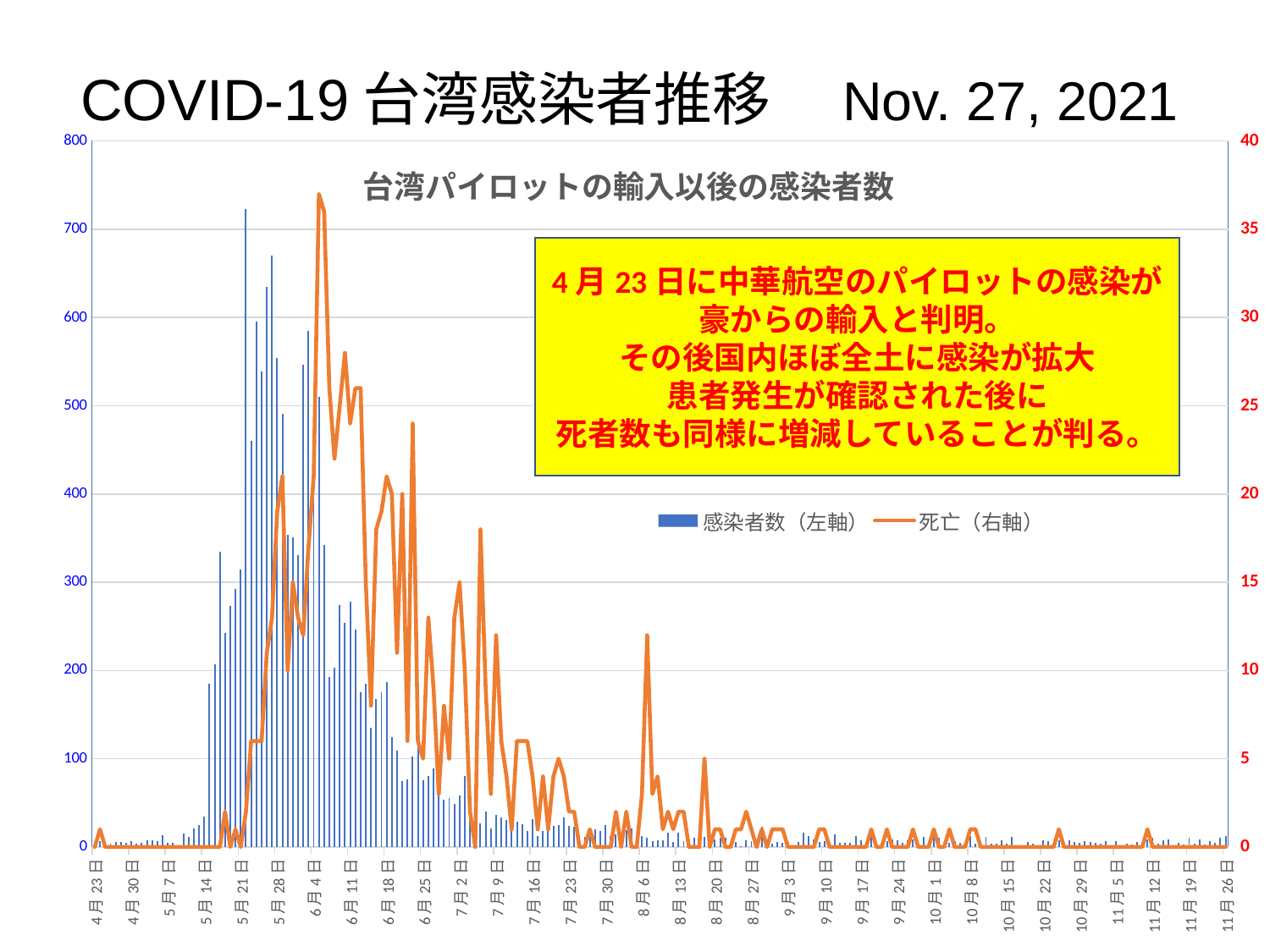
How many series does the chart legend list? 2 Is the highest value of 感染者数 greater or less than 600? greater Is the value of 死亡 at the spike around 8月6日 greater or less than 5? greater Which is larger: the 感染者数 value in late May or the 感染者数 value in mid October? late May Do the 感染者数 values rise or fall from early June to late November? fall What is the maximum value shown on the left vertical axis? 800 Which series is plotted as the orange line? 死亡（右軸） Is the highest value of 死亡 greater or less than 30? greater Which series is plotted as blue bars? 感染者数（左軸） What is the maximum value shown on the right vertical axis? 40 What is the first date label on the x axis? 4月23日 What kind of chart is shown on the slide? A combined bar and line chart